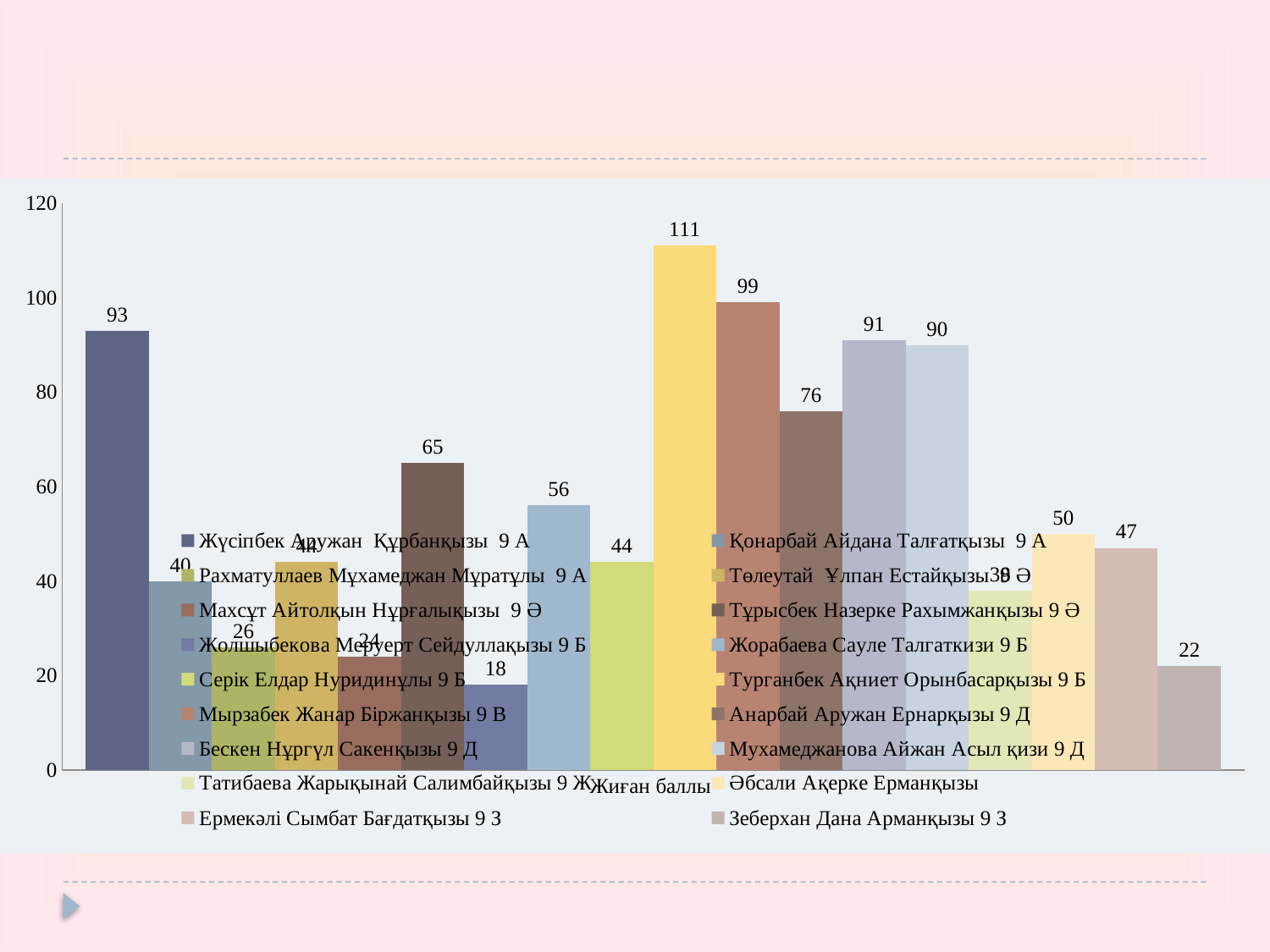
What is the category label shown on the x axis? Жиған баллы What type of chart is shown on the slide? bar chart Is the value for Тұрысбек Назерке Рахымжанқызы 9 Ә greater or less than 60? greater How many series does the legend list? 18 What is the lowest value shown in the chart? 18 What is the value for Мырзабек Жанар Біржанқызы 9 В? 99 What is the highest value shown in the chart? 111 What is the value for Жүсіпбек Аружан Құрбанқызы 9 А? 93 Which student has the highest value in the chart? Турганбек Ақниет Орынбасарқызы 9 Б What is the difference between the values for Турганбек Ақниет Орынбасарқызы 9 Б and Мырзабек Жанар Біржанқызы 9 В? 12 What is the value for Зеберхан Дана Арманқызы 9 З? 22 Which is larger, the value for Бескен Нұргүл Сакенқызы 9 Д or the value for Анарбай Аружан Ернарқызы 9 Д? Бескен Нұргүл Сакенқызы 9 Д